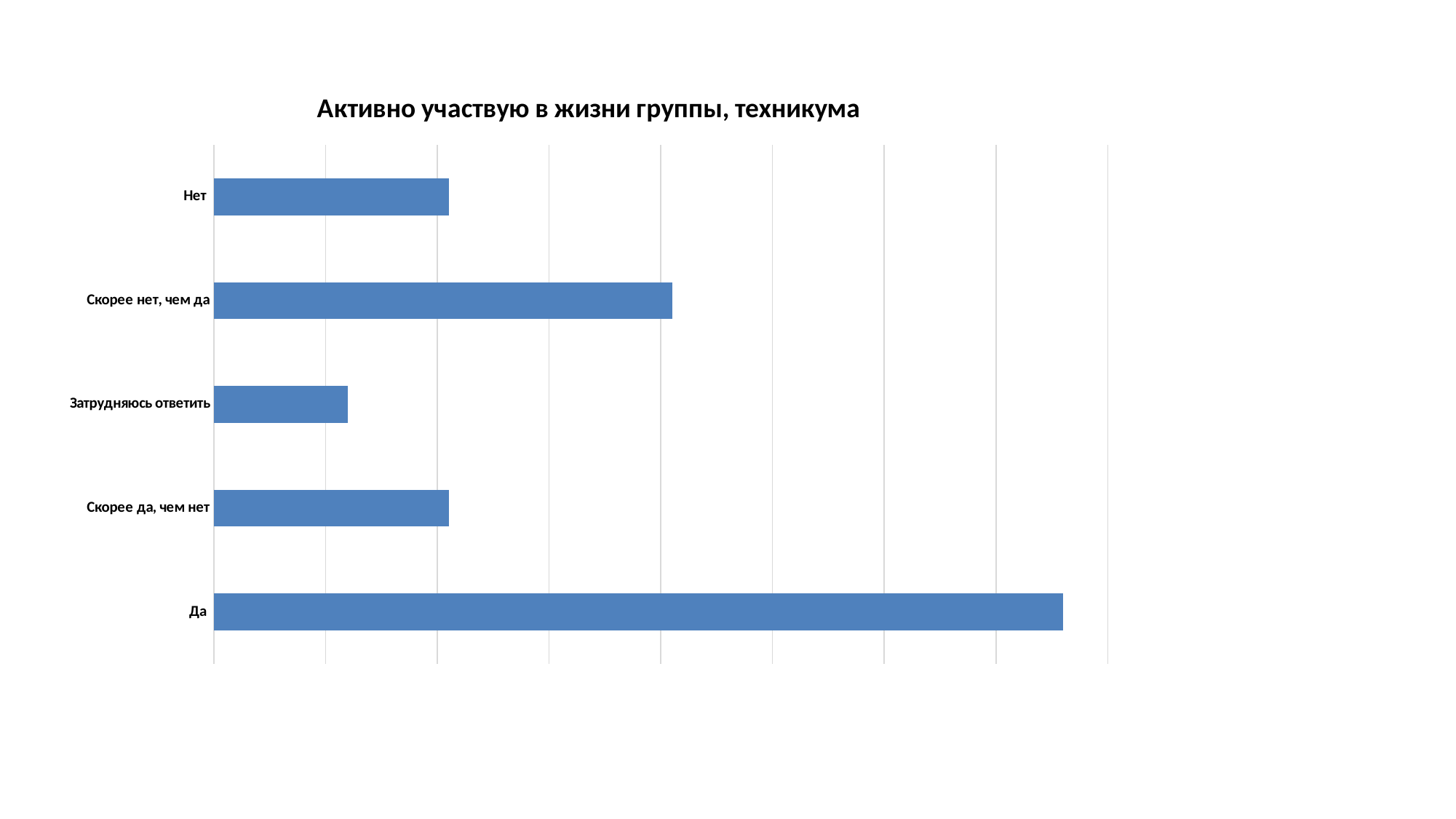
Which is larger, the value for "Скорее нет, чем да" or the value for "Затрудняюсь ответить"? Скорее нет, чем да Which category has the lowest value? Затрудняюсь ответить What is the title of the chart? Активно участвую в жизни группы, техникума How many categories are shown in the chart? 5 Which is larger, the value for "Скорее да, чем нет" or the value for "Затрудняюсь ответить"? Скорее да, чем нет Which category is listed at the bottom of the chart? Да Are the bars in the chart horizontal or vertical? Horizontal Which category has the highest value? Да What type of chart is shown on the slide? Bar chart Which is larger, the value for "Да" or the value for "Скорее нет, чем да"? Да